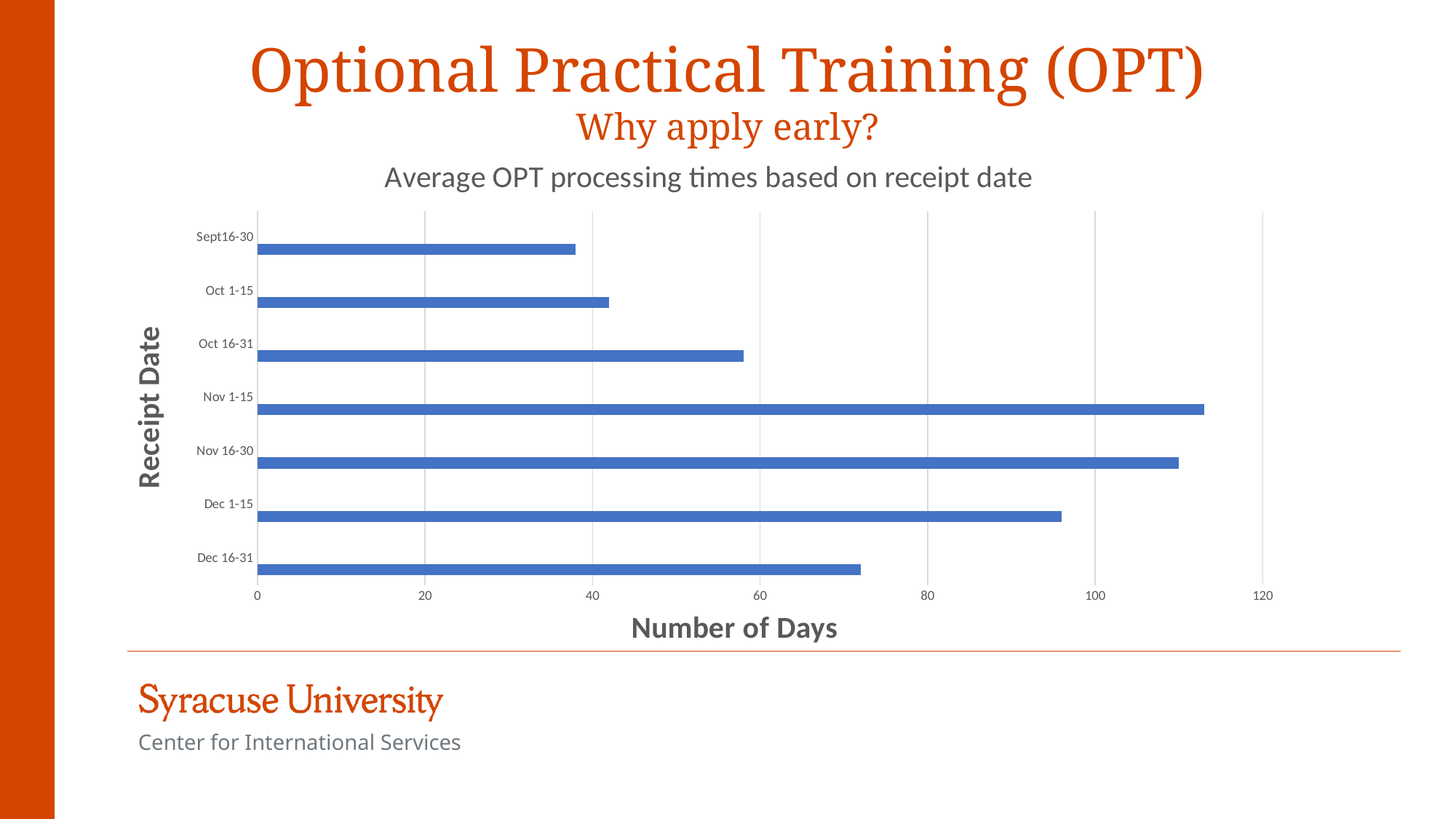
Which receipt date has the lowest average OPT processing time? Sept16-30 How many receipt date categories are plotted in the chart? 7 Is the value for Oct 1-15 greater or less than 40? greater What is the label of the horizontal axis of the chart? Number of Days Is the value for Dec 1-15 greater or less than 100? less Is the value for Nov 1-15 greater or less than 100? greater Which has a larger value, Oct 16-31 or Dec 16-31? Dec 16-31 What is the title of the chart? Average OPT processing times based on receipt date What kind of chart is shown on the slide? bar chart